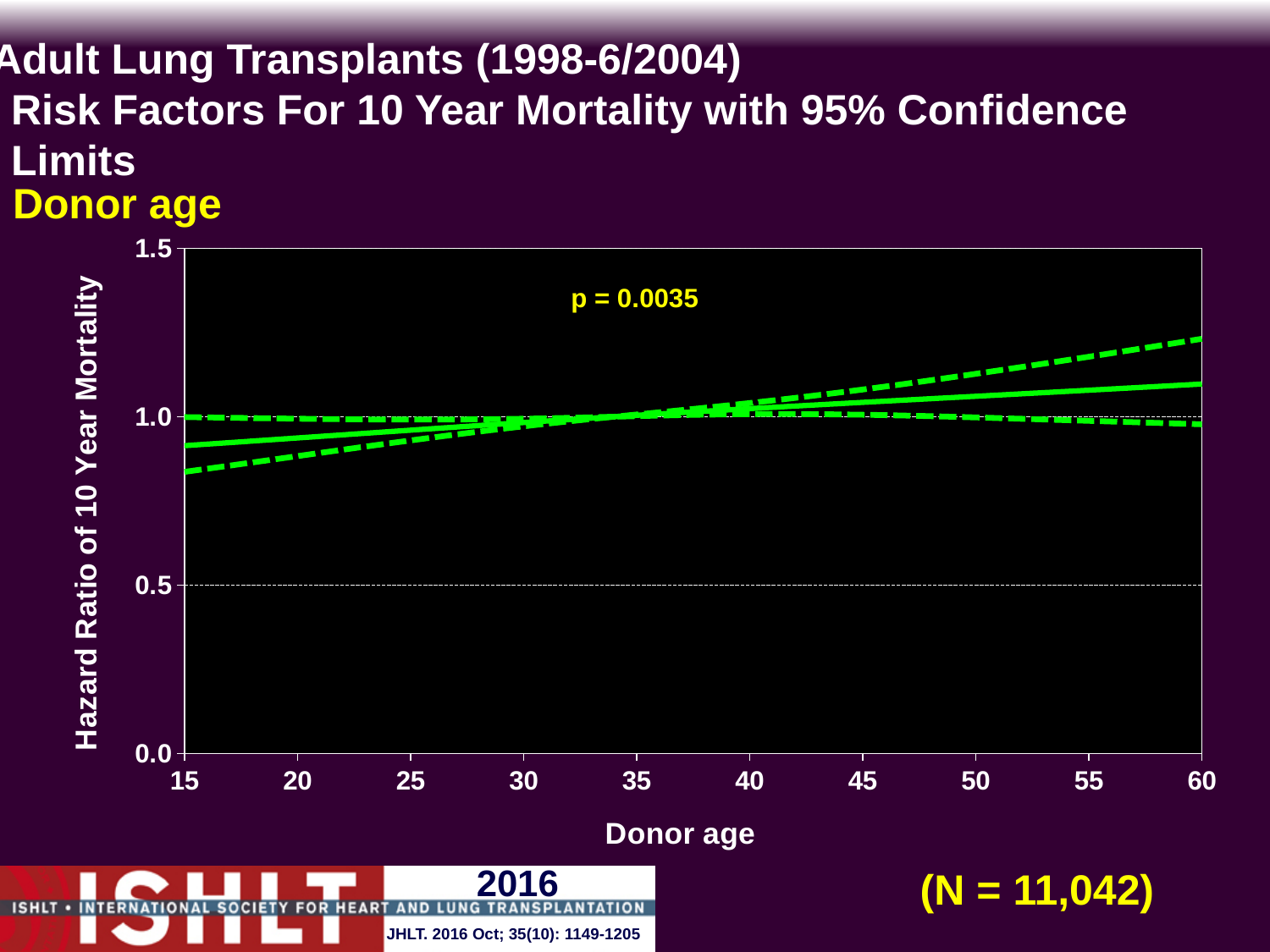
Which is larger, the hazard ratio (solid line) at donor age 60 or at donor age 15? donor age 60 What is the label of the x axis of the chart? Donor age What is the label of the y axis of the chart? Hazard Ratio of 10 Year Mortality Is the hazard ratio (solid line) at donor age 60 greater or less than 1.0? greater Is the hazard ratio (solid line) at donor age 60 greater or less than 1.5? less Is the hazard ratio (solid line) at donor age 15 greater or less than 1.0? less What p-value is printed on the chart? p = 0.0035 What sample size (N) is shown on the slide? N = 11,042 What kind of chart is shown on the slide? line chart Does the solid hazard ratio line rise or fall as donor age increases from 15 to 60? rise